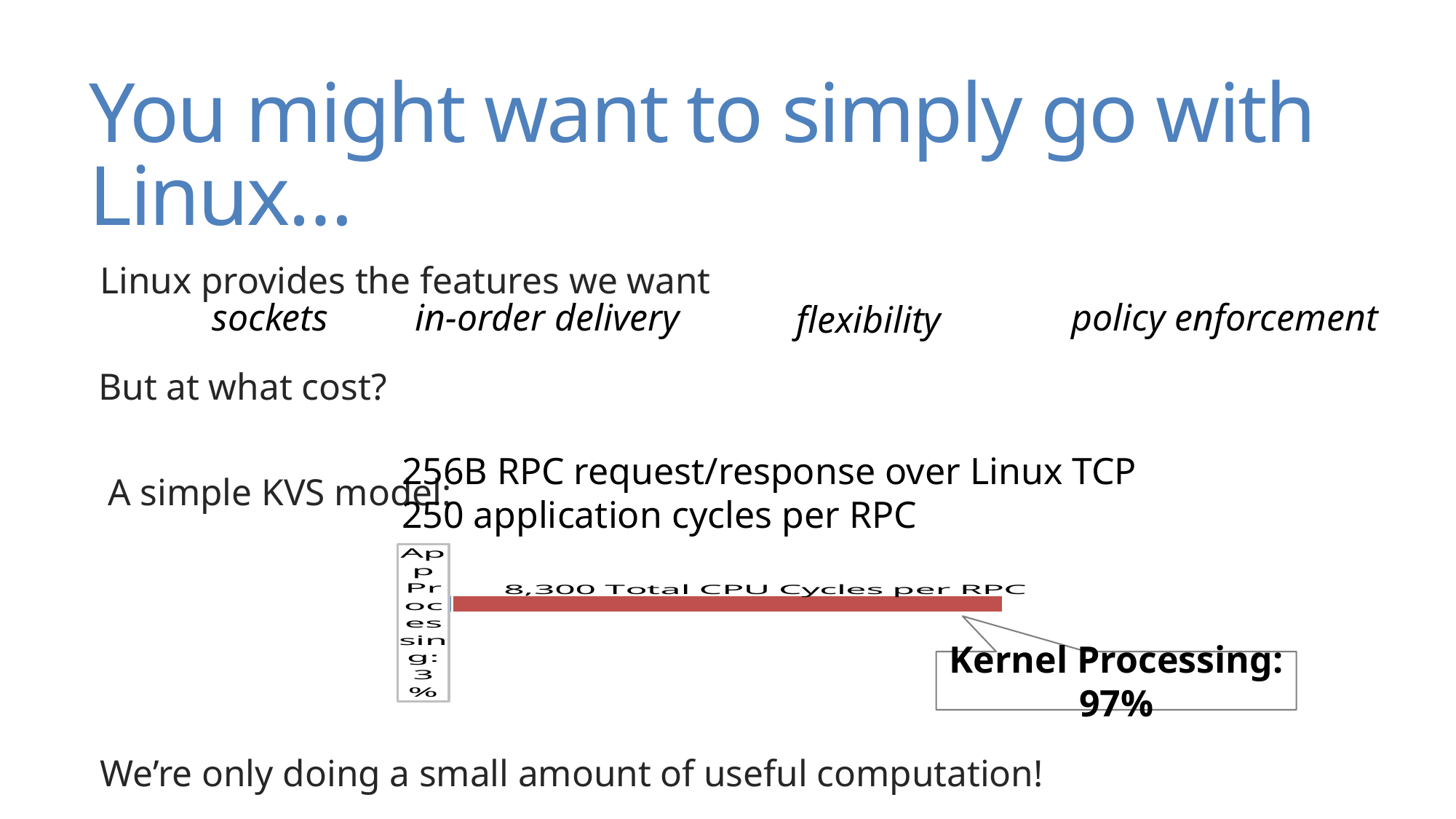
How many segments make up the bar in the chart? 2 What is the title of the chart on the slide? 8,300 Total CPU Cycles per RPC Which segment of the bar is larger, App Processing or Kernel Processing? Kernel Processing What percentage of CPU cycles per RPC does the chart attribute to App Processing? 3% What is the difference in percentage points between Kernel Processing and App Processing? 94% What colour is the Kernel Processing segment of the bar? red What kind of chart is shown on the slide? bar chart Which category has the largest share in the chart? Kernel Processing What do the App Processing and Kernel Processing segments add up to? 100% How many total CPU cycles per RPC does the chart title state? 8,300 What percentage of CPU cycles per RPC does the chart attribute to Kernel Processing? 97% Which category has the smallest share in the chart? App Processing